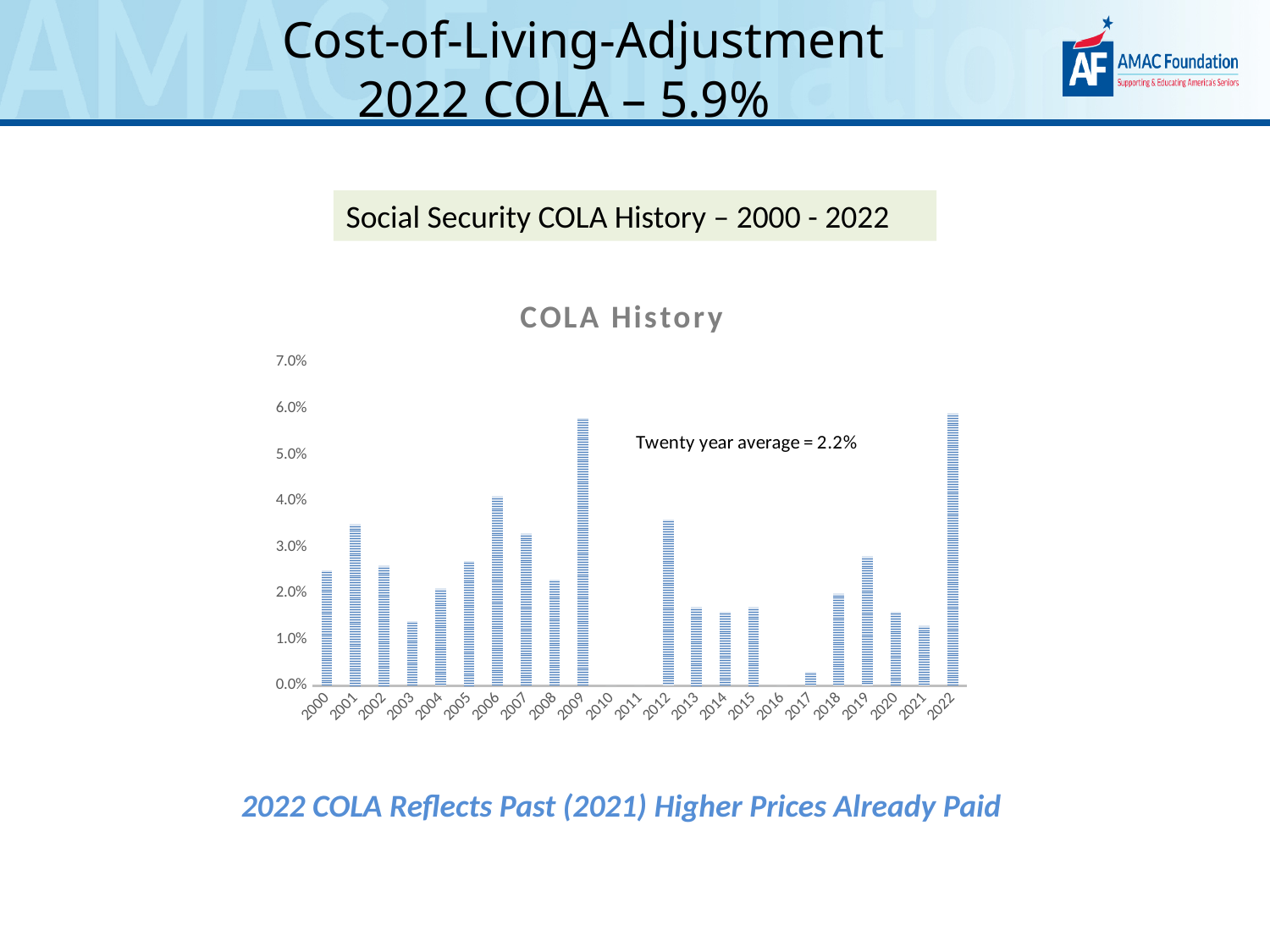
What twenty year average is noted on the COLA History chart? 2.2% Which year has the larger COLA, 2019 or 2020? 2019 What kind of chart is the COLA History chart? bar chart Is the value for 2009 greater or less than 5.0%? greater What is the title of the chart? COLA History What is the COLA value for 2022 according to the slide? 5.9% Is the value for 2017 greater or less than 1.0%? less Which year has the larger COLA, 2006 or 2007? 2006 Is the value for 2001 greater or less than 3.0%? greater How many years are shown on the x axis of the COLA History chart? 23 Which year has the larger COLA, 2001 or 2002? 2001